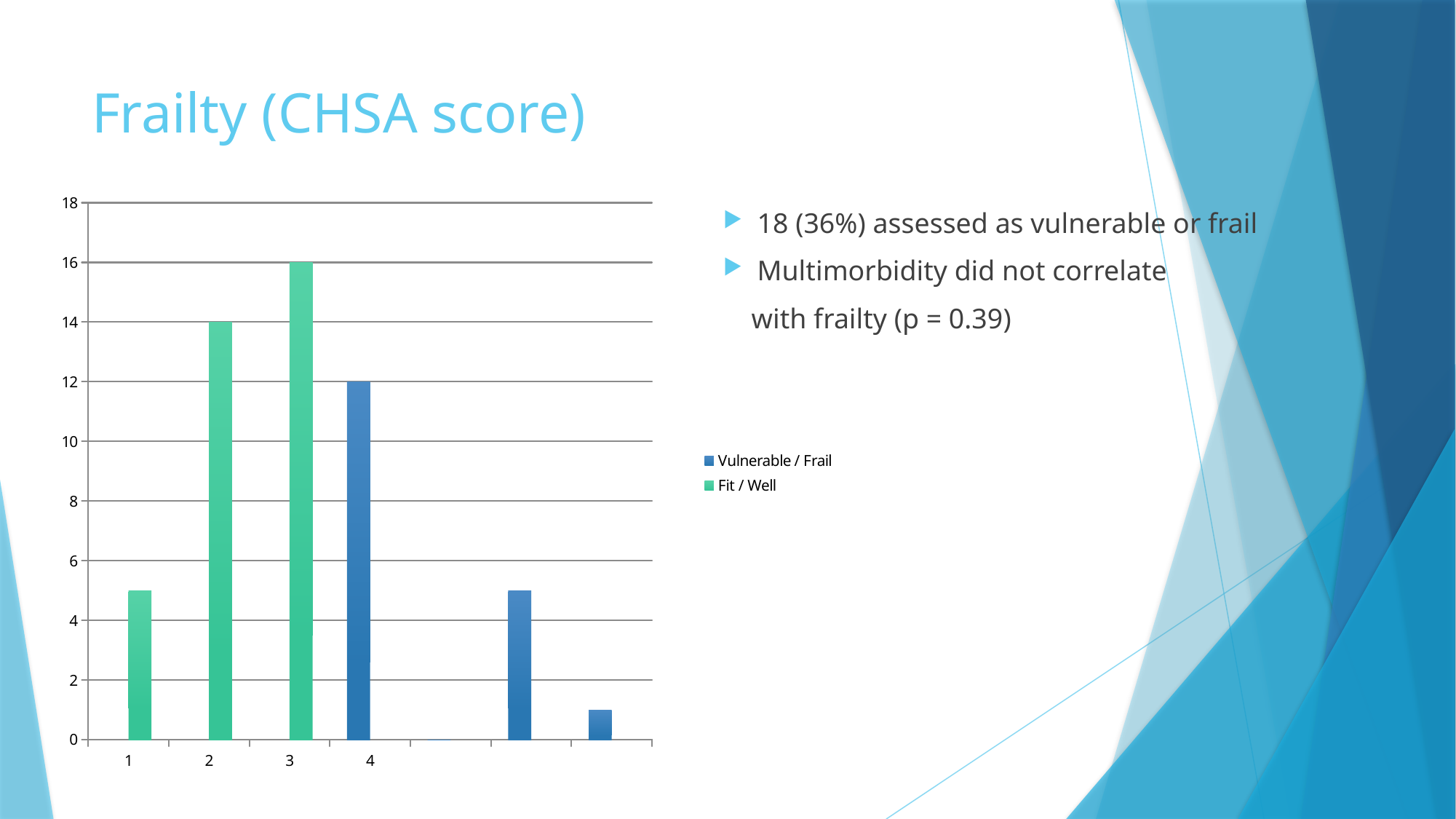
Which is larger, the bar for category 2 or the bar for category 4? 2 What is the difference between the bars for category 3 and category 4? 4 Which category has the tallest bar in the chart? 3 What is the value of the bar for category 4? 12 Which series does the bar for category 4 belong to? Vulnerable / Frail What is the value of the bar for category 2? 14 What is the value of the bar for category 3? 16 Is the value for category 1 greater or less than 6? less Among categories 1 to 4, which has the lowest bar? 1 What kind of chart is shown on the slide? bar chart How many series does the legend list? 2 What are the two entries in the chart legend? Vulnerable / Frail; Fit / Well